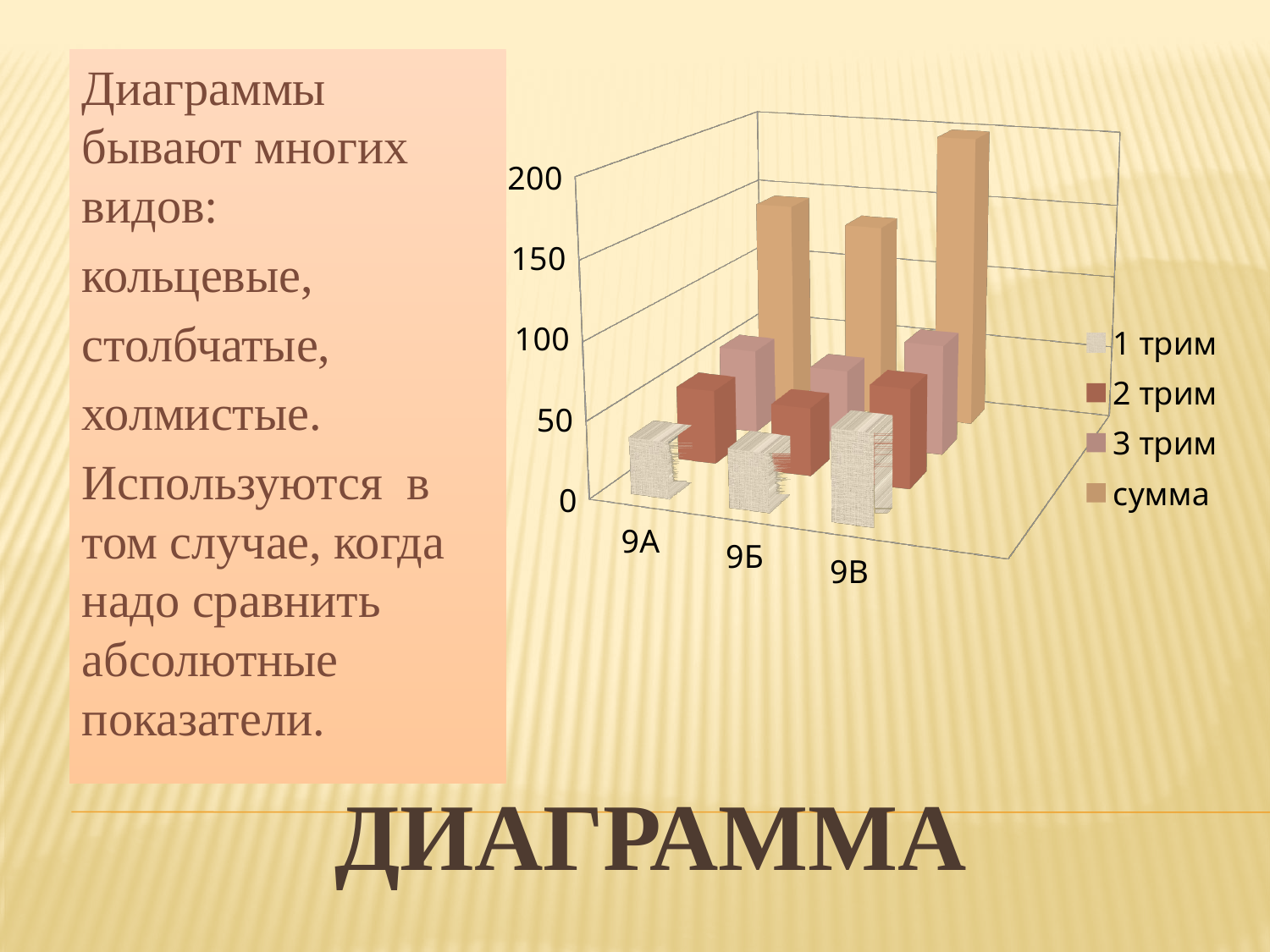
Is the value of 2 трим for 9А greater or less than 150? less How many series does the chart legend list? 4 How many categories are shown on the x axis of the chart? 3 Which is larger for category 9В: the value of сумма or the value of 3 трим? сумма Which series has the lowest value for category 9А? 1 трим Which category has the highest value for the сумма series? 9В What are the category labels on the x axis of the chart? 9А, 9Б, 9В Which series has the highest value for category 9В? сумма What is the last entry listed in the chart legend? сумма Is the value of сумма for 9В greater or less than 150? greater Is the value of 1 трим for 9Б greater or less than 100? less What kind of chart is shown on the slide? bar chart